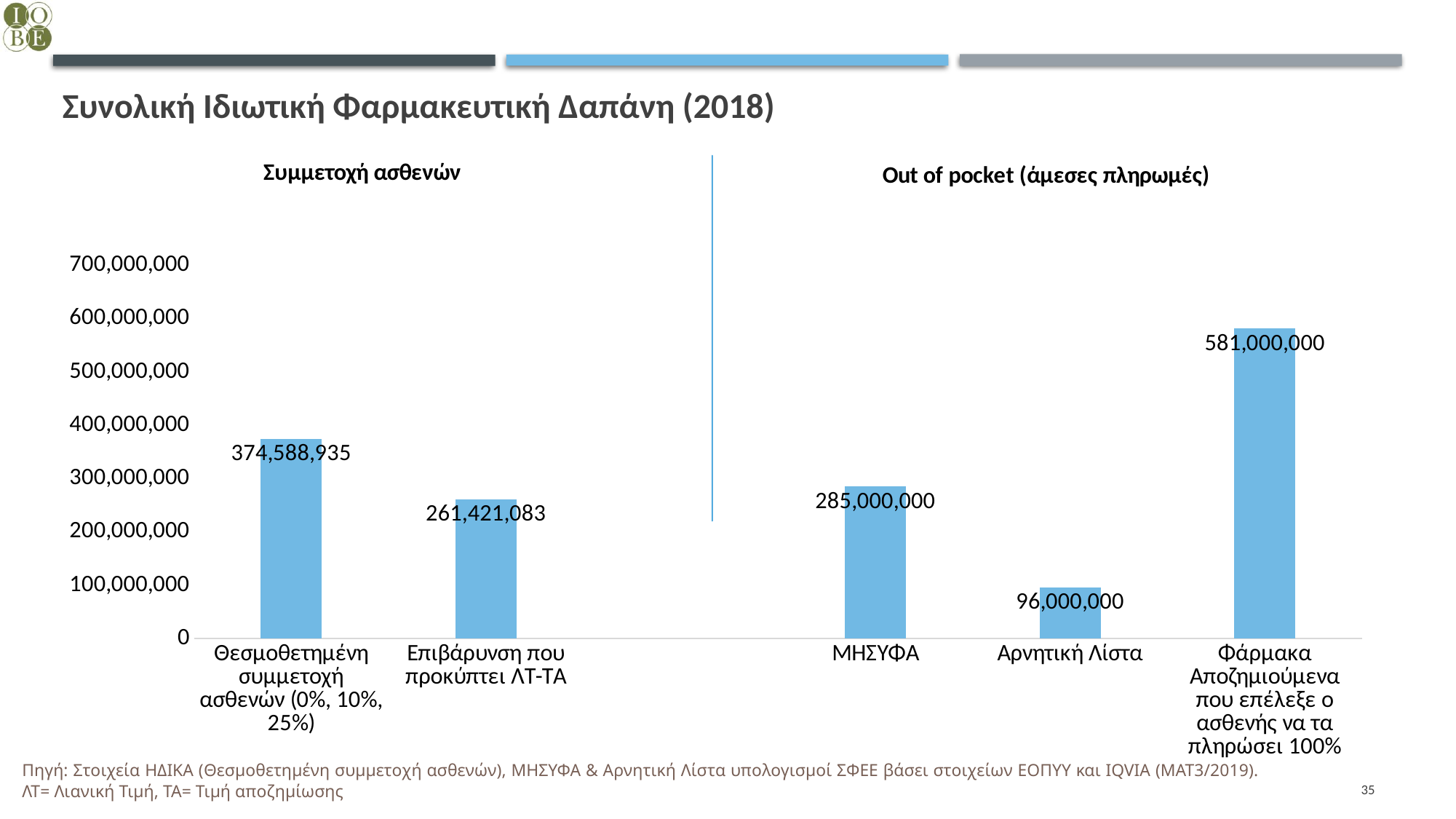
What kind of chart is shown on the slide? bar chart Which category has the highest value? Φάρμακα Αποζημιούμενα που επέλεξε ο ασθενής να τα πληρώσει 100% Which category has the lowest value? Αρνητική Λίστα What is the difference between the values for Θεσμοθετημένη συμμετοχή ασθενών (0%, 10%, 25%) and Επιβάρυνση που προκύπτει ΛΤ-ΤΑ? 113,167,852 What is the value for ΜΗΣΥΦΑ? 285,000,000 Is the value for Φάρμακα Αποζημιούμενα που επέλεξε ο ασθενής να τα πληρώσει 100% greater or less than 500,000,000? greater How many bars are shown in the chart? 5 What is the value for Θεσμοθετημένη συμμετοχή ασθενών (0%, 10%, 25%)? 374,588,935 What is the value for Επιβάρυνση που προκύπτει ΛΤ-ΤΑ? 261,421,083 Which is larger, the value for ΜΗΣΥΦΑ or the value for Επιβάρυνση που προκύπτει ΛΤ-ΤΑ? ΜΗΣΥΦΑ What is the difference between the values for ΜΗΣΥΦΑ and Αρνητική Λίστα? 189,000,000 What is the value for Αρνητική Λίστα? 96,000,000